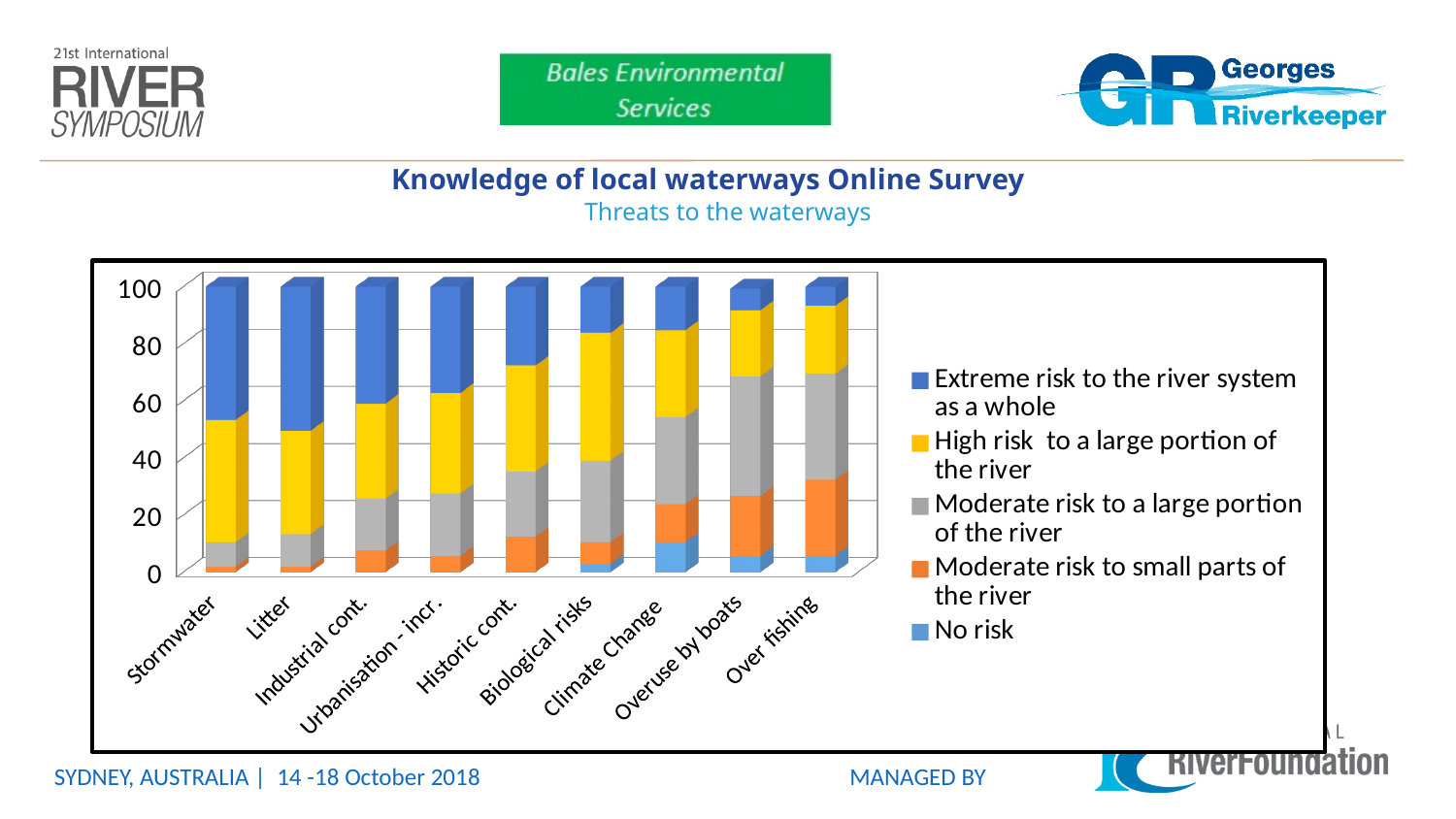
What kind of chart is shown on the slide? stacked bar chart How many series does the legend list? 5 Is the 'Extreme risk to the river system as a whole' value for Stormwater greater or less than 40? greater Which has the larger 'Moderate risk to a large portion of the river' segment, Over fishing or Stormwater? Over fishing Which legend entry is shown in light blue? No risk What is the title of the chart? Knowledge of local waterways Online Survey Moving from Stormwater on the left to Over fishing on the right, does the 'Extreme risk to the river system as a whole' segment rise or fall? fall Is the 'Extreme risk to the river system as a whole' value for Litter greater or less than 40? greater What is the total height of the Stormwater bar? 100 Is the 'Extreme risk to the river system as a whole' value for Over fishing greater or less than 20? less How many threat categories are shown along the x axis? 9 Which has the larger 'Extreme risk to the river system as a whole' segment, Stormwater or Over fishing? Stormwater